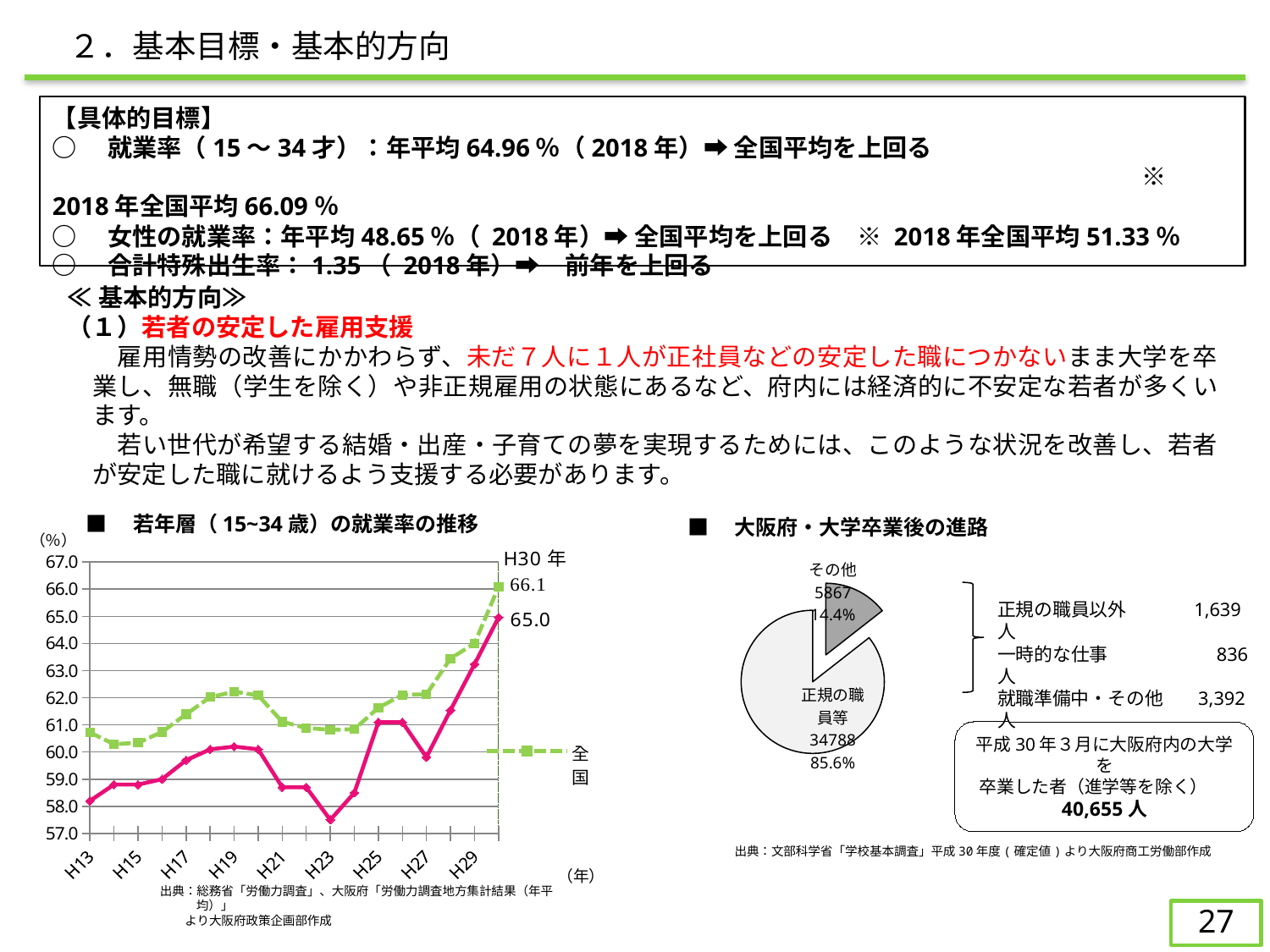
In the line chart 若年層（15~34歳）の就業率の推移, what is the value of the solid pink line in H30? 65.0 In the pie chart 大阪府・大学卒業後の進路, which slice is the largest? 正規の職員等 In the line chart 若年層（15~34歳）の就業率の推移, what is the value of the 全国 series in H30? 66.1 In the line chart 若年層（15~34歳）の就業率の推移, which is higher in H30, the 全国 series or the pink line? 全国 In the line chart 若年層（15~34歳）の就業率の推移, is the value of the pink line at H23 greater or less than 58.0? less In the line chart 若年層（15~34歳）の就業率の推移, is the value of the 全国 series at H13 greater or less than 60.0? greater In the line chart 若年層（15~34歳）の就業率の推移, does the 全国 series rise or fall from H25 to H30? rise In the pie chart 大阪府・大学卒業後の進路, what is the value shown for 正規の職員等? 34788 What kind of chart is 若年層（15~34歳）の就業率の推移? line chart How many slices does the pie chart 大阪府・大学卒業後の進路 have? 2 In the line chart 若年層（15~34歳）の就業率の推移, what is the difference between the 全国 value and the pink line value in H30? 1.1 In the pie chart 大阪府・大学卒業後の進路, what share does その他 have? 14.4%